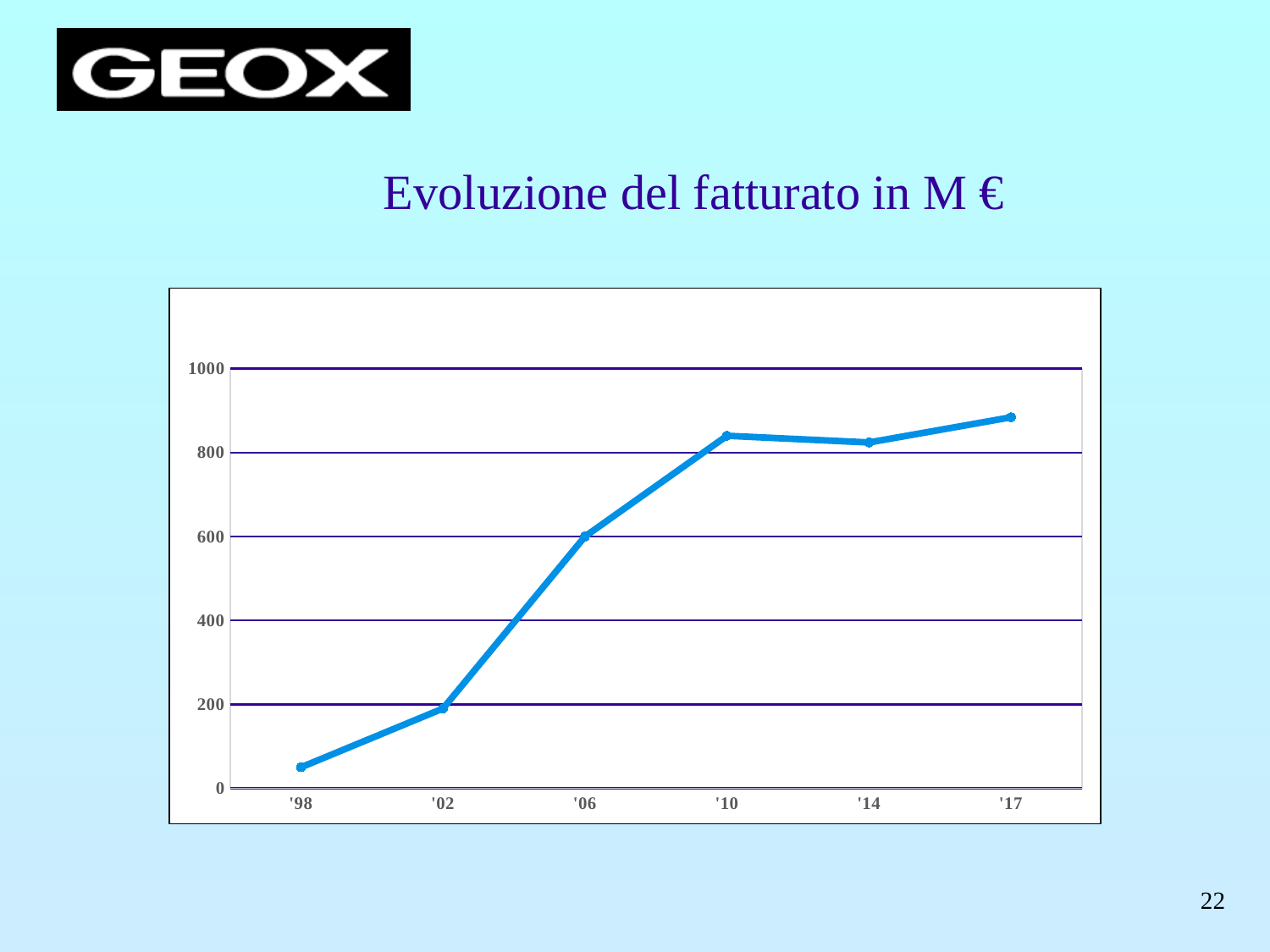
Which year has the highest value? '17 Is the value for '98 greater or less than 200? less Is the value for '17 greater or less than 1000? less Do the values generally rise or fall from '98 to '17? rise How many data points are plotted on the line? 6 What is the title of the chart? Evoluzione del fatturato in M € Which is larger, the value for '98 or the value for '02? '02 Which is larger, the value for '06 or the value for '10? '10 Is the value for '10 greater or less than 800? greater What kind of chart is shown on the slide? line chart Which year has the lowest value? '98